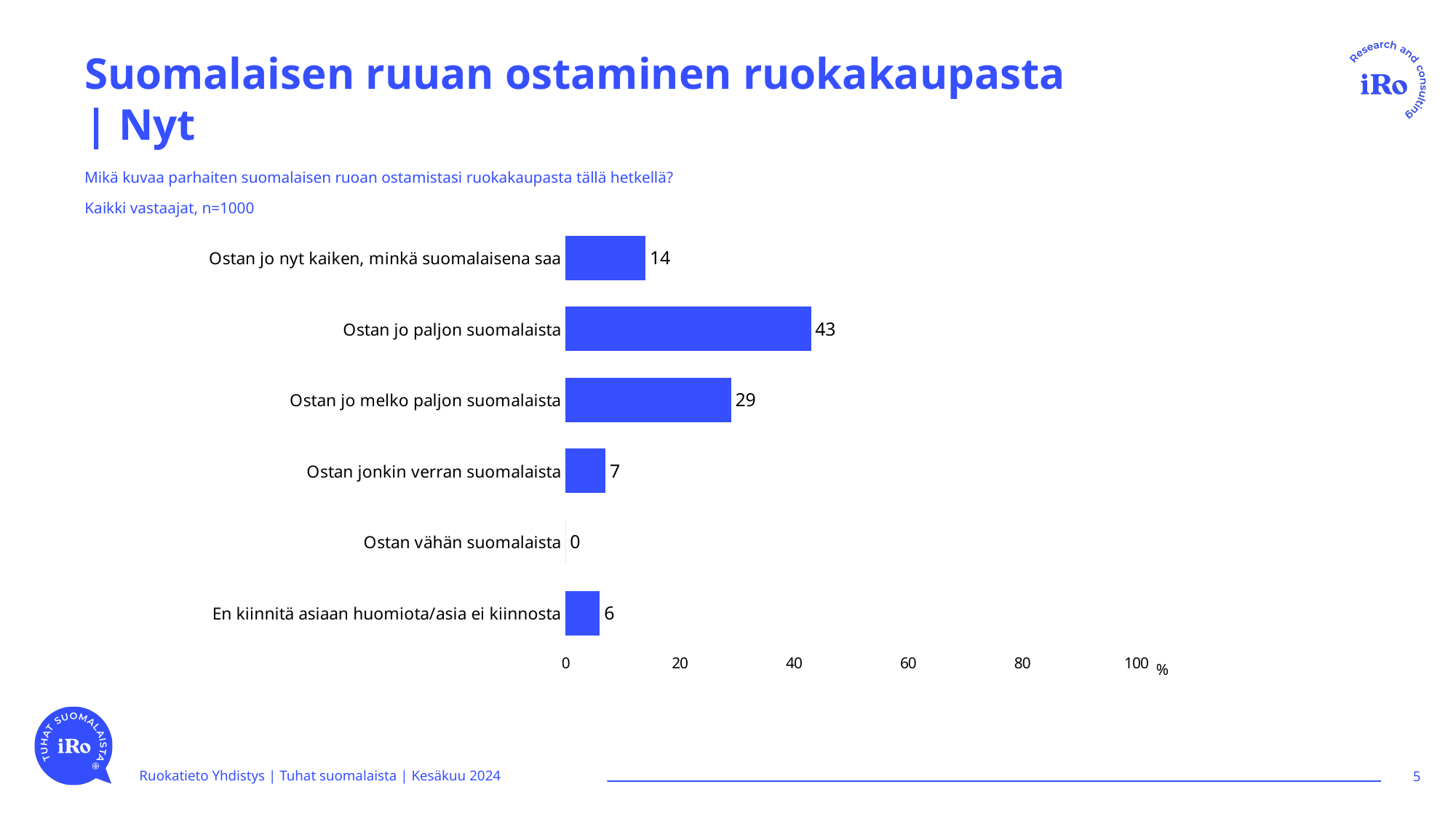
What is the sample size stated above the chart? n=1000 What is the value for "Ostan jo nyt kaiken, minkä suomalaisena saa"? 14 Is the value for "Ostan jo melko paljon suomalaista" greater or less than 20? greater What is the value for "Ostan vähän suomalaista"? 0 What kind of chart is shown on the slide? bar chart Which is larger: the value for "Ostan jonkin verran suomalaista" or "En kiinnitä asiaan huomiota/asia ei kiinnosta"? Ostan jonkin verran suomalaista Which category has the lowest value? Ostan vähän suomalaista What is the value for "Ostan jonkin verran suomalaista"? 7 Which category has the highest value? Ostan jo paljon suomalaista What is the difference between the values for "Ostan jo paljon suomalaista" and "Ostan jo melko paljon suomalaista"? 14 What is the value for "Ostan jo paljon suomalaista"? 43 How many categories are shown in the chart? 6